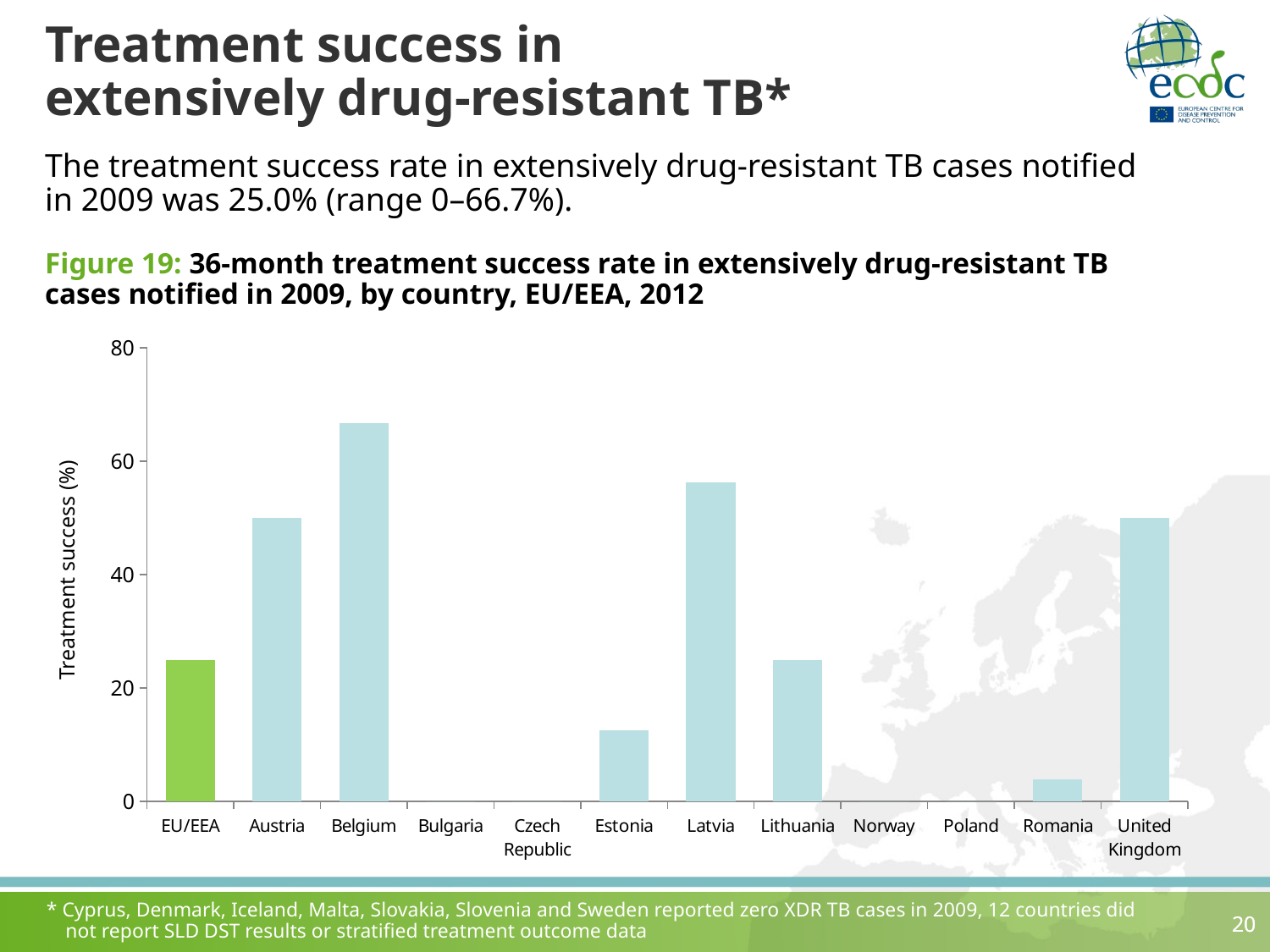
Which has a higher treatment success rate, Estonia or Romania? Estonia Is the value for Belgium greater or less than 60? greater Which country has the highest 36-month treatment success rate in the chart? Belgium Is the value for Estonia greater or less than 20? less What is the label on the y axis of the chart? Treatment success (%) Is the value for Latvia greater or less than 40? greater What is the treatment success rate for EU/EEA shown in the chart? 25.0% Which has a higher treatment success rate, Latvia or Lithuania? Latvia How many countries in the chart show no bar (a value of 0)? 4 What kind of chart is shown in Figure 19? Bar chart How many categories are shown on the x axis of the chart? 12